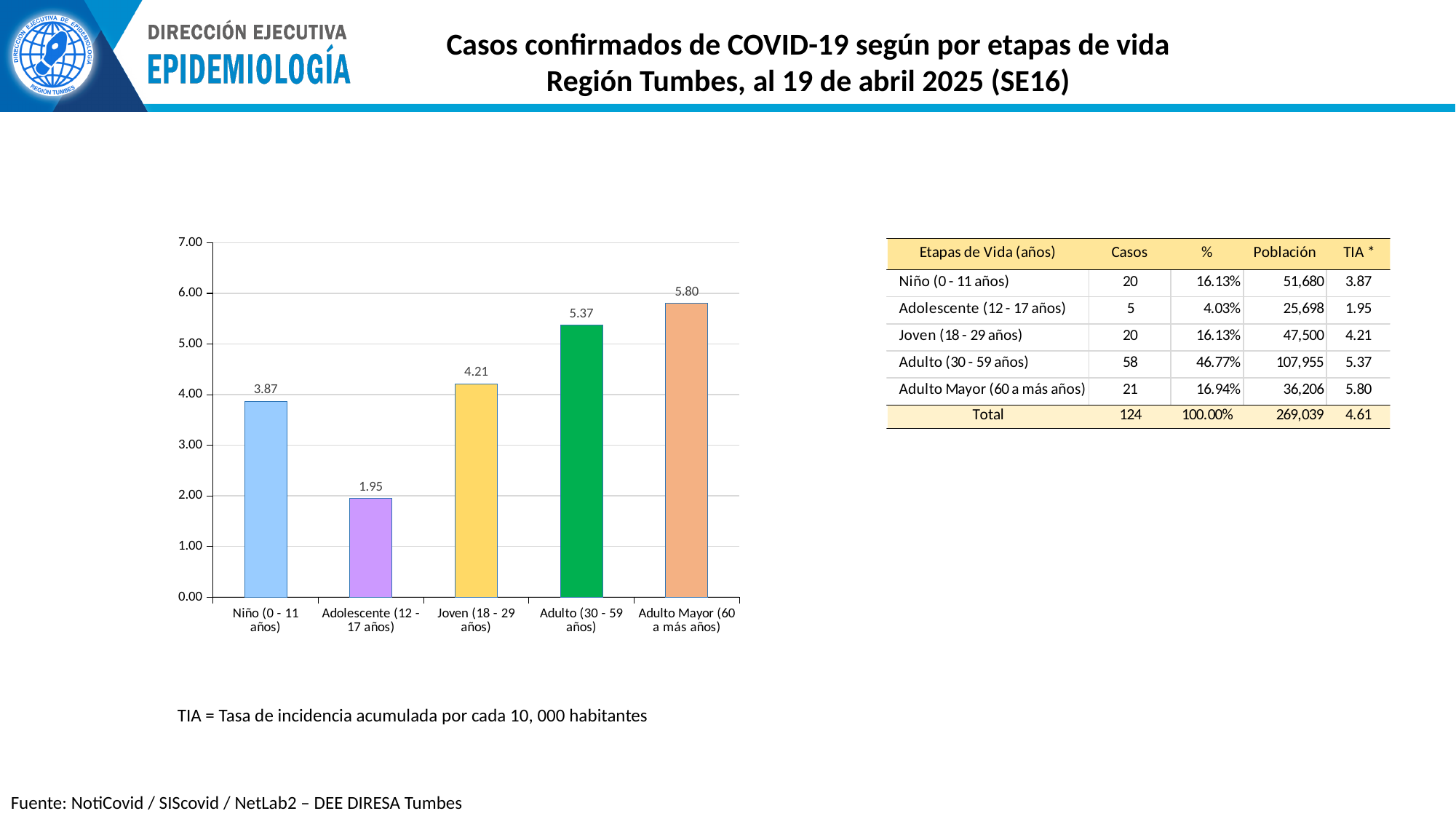
What is the value shown for Adolescente (12 - 17 años)? 1.95 What is the maximum value shown on the chart's vertical axis? 7.00 What is the difference between the values for Adulto Mayor (60 a más años) and Adulto (30 - 59 años)? 0.43 What is the value shown for Adulto (30 - 59 años)? 5.37 What is the value shown for Joven (18 - 29 años)? 4.21 What kind of chart is shown on the slide? bar chart Is the value for Adulto (30 - 59 años) greater or less than 5.00? greater Which age group has the lowest bar in the chart? Adolescente (12 - 17 años) What is the TIA value plotted for Niño (0 - 11 años)? 3.87 Which age group has the highest bar in the chart? Adulto Mayor (60 a más años) Which is larger, the value for Niño (0 - 11 años) or the value for Joven (18 - 29 años)? Joven (18 - 29 años) How many age-group categories are plotted in the chart? 5